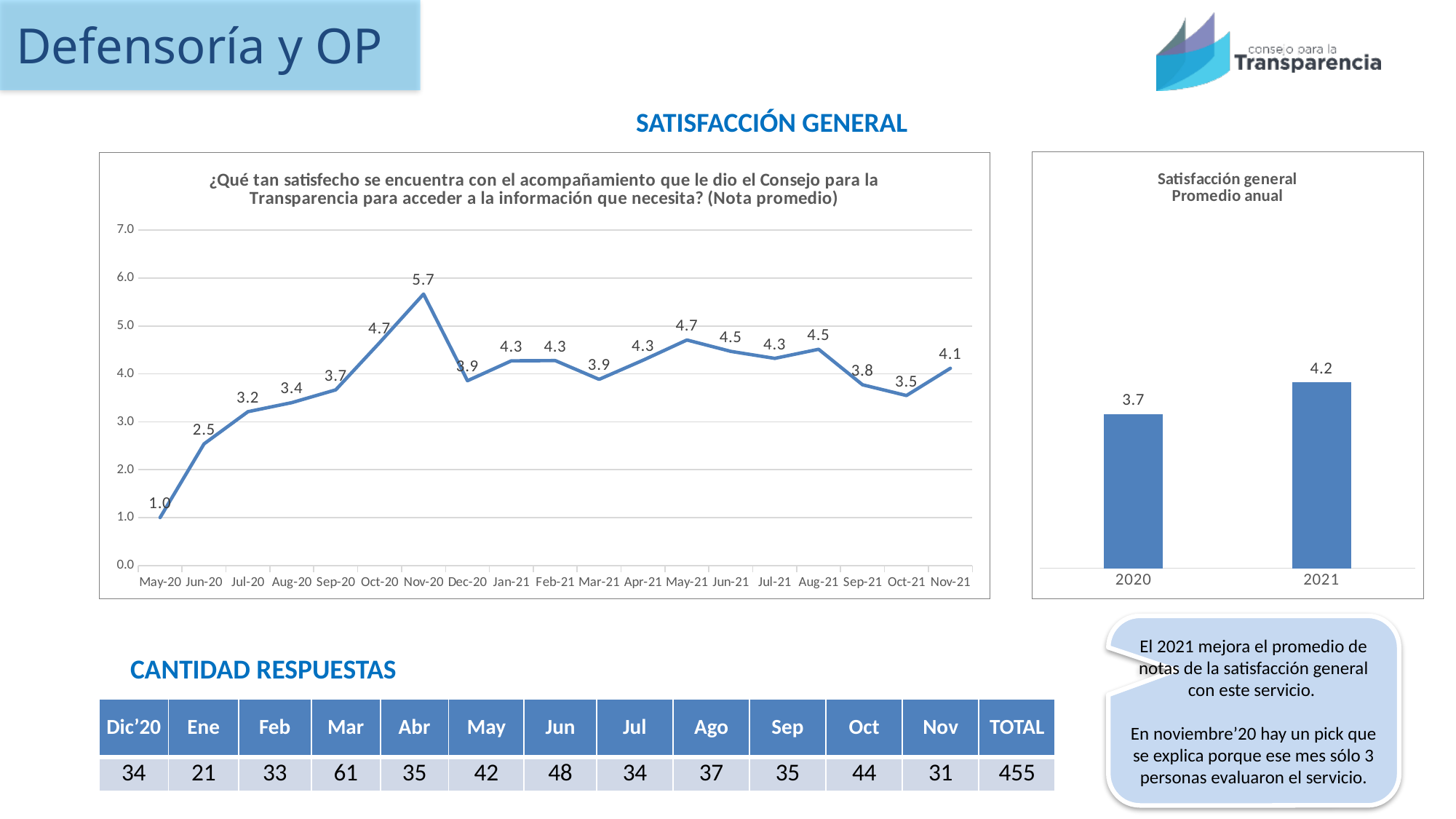
In the line chart on the left, what is the value for Nov-20? 5.7 In the line chart on the left, which is larger, the value for Oct-20 or the value for Sep-21? Oct-20 In the line chart on the left, which month has the lowest value? May-20 In the line chart on the left, how many months are plotted? 19 In the line chart on the left, what is the value for May-20? 1.0 In the chart titled 'Satisfacción general Promedio anual', what is the value for 2021? 4.2 What kind of chart is the chart titled 'Satisfacción general Promedio anual'? bar chart In the line chart on the left, which month has the highest value? Nov-20 In the chart titled 'Satisfacción general Promedio anual', what is the difference between 2021 and 2020? 0.5 In the line chart on the left, do the values rise or fall from May-20 to Nov-20? rise In the line chart on the left, what is the difference between the values for Nov-20 and Dec-20? 1.8 In the line chart on the left, what is the value for Oct-21? 3.5